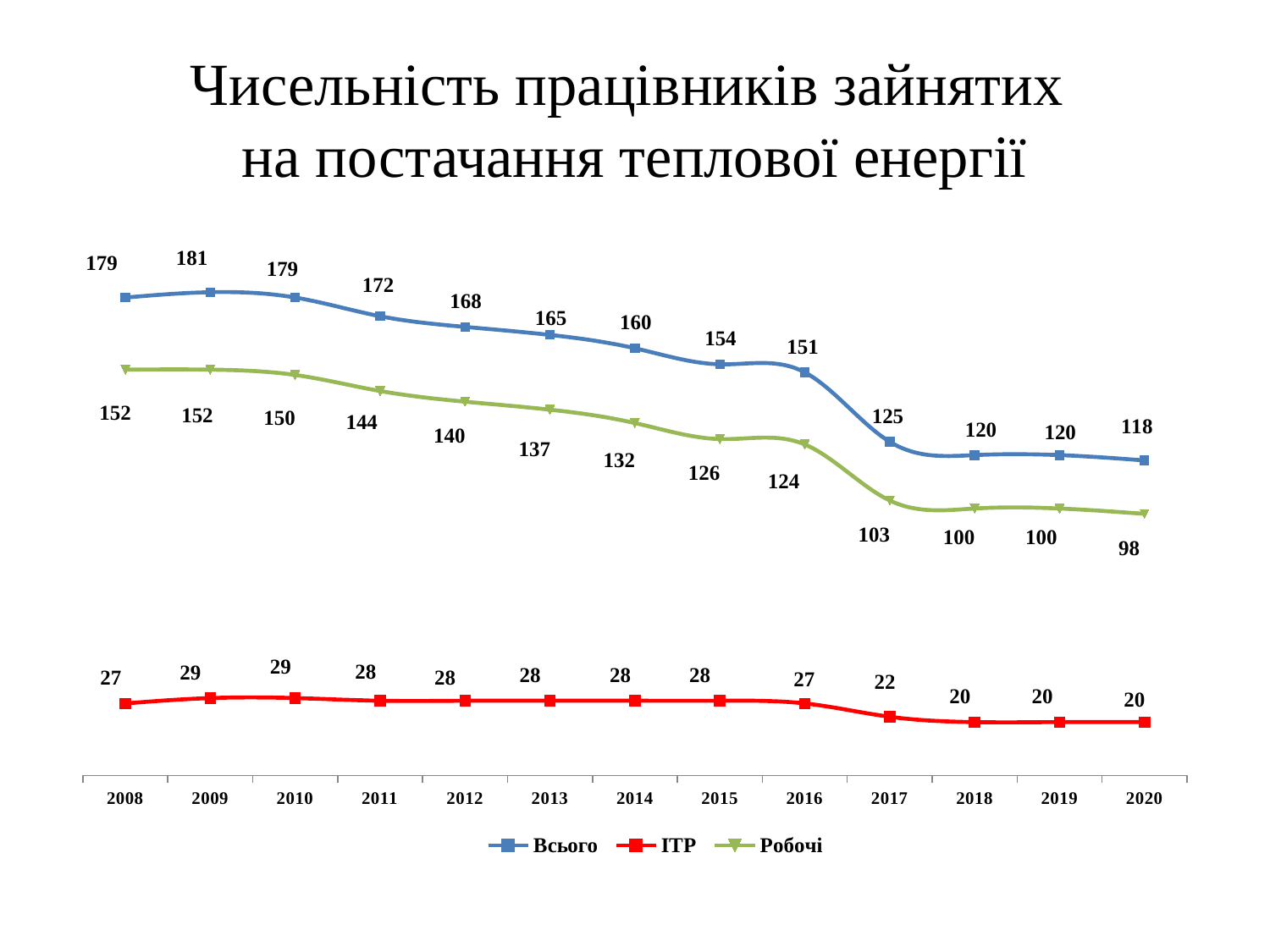
Which is larger: the Робочі value in 2011 or the Робочі value in 2014? 2011 Does the Всього series generally rise or fall from 2008 to 2020? fall What is the value of the ІТР series in 2017? 22 In which year is the Робочі series at its lowest? 2020 What kind of chart is shown on the slide? line chart What is the difference between the Всього values in 2008 and 2020? 61 What is the value of the Робочі series in 2016? 124 What is the value of the Всього series in 2009? 181 How many series does the legend list? 3 How many years are shown on the x axis? 13 Which series is drawn in red? ІТР In which year is the Всього series at its highest? 2009